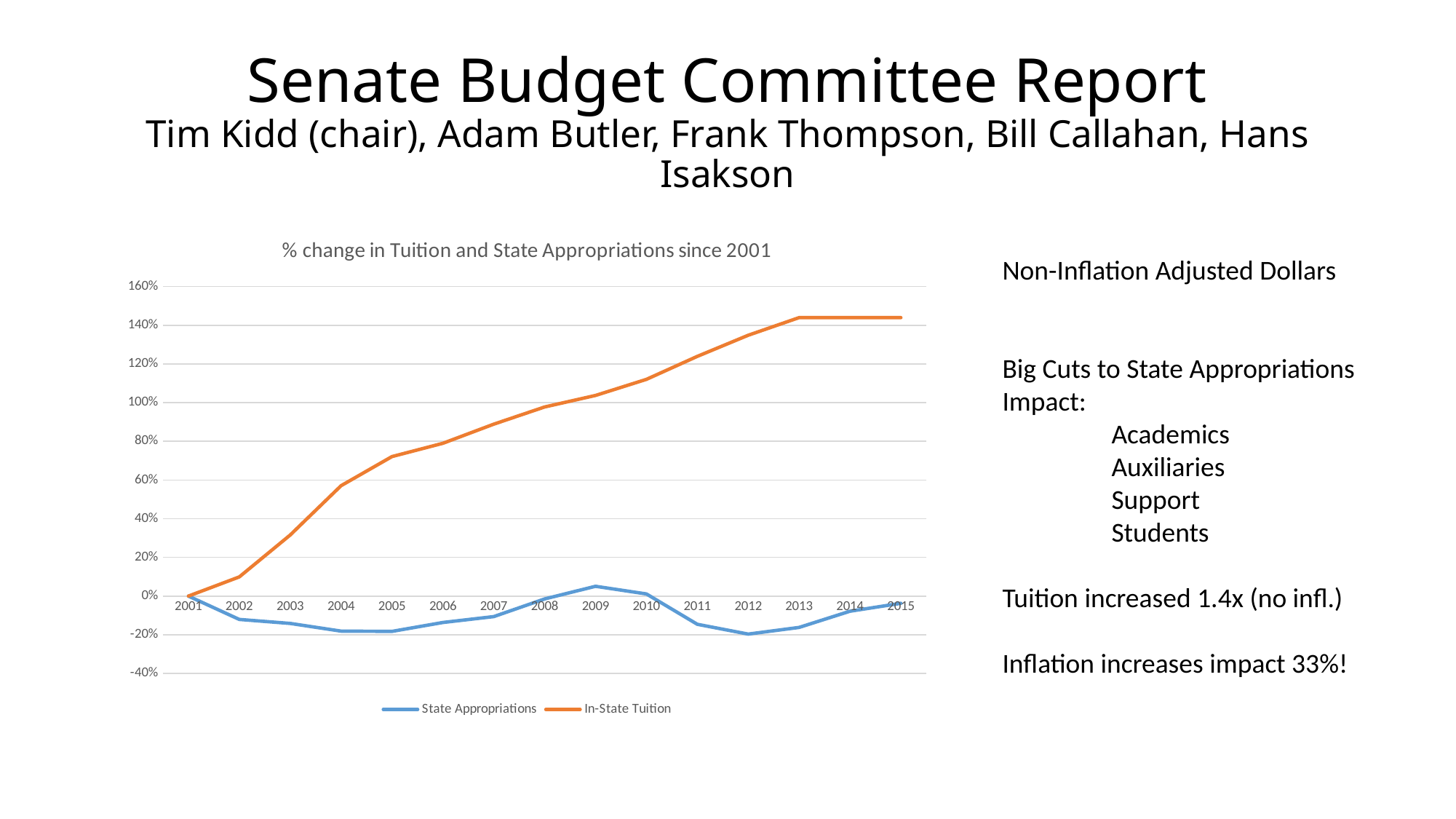
Which series is drawn in orange in the chart? In-State Tuition Is the value for In-State Tuition in 2015 greater or less than 120%? greater What is the title of the chart? % change in Tuition and State Appropriations since 2001 Is the value for State Appropriations in 2012 greater or less than 0%? less How many series does the chart's legend list? 2 In 2010, which series has the higher value, State Appropriations or In-State Tuition? In-State Tuition What kind of chart is shown on the slide? line chart How many years are plotted along the x axis of the chart? 15 Is the value for In-State Tuition in 2003 greater or less than 40%? less Does the In-State Tuition line rise or fall from 2001 to 2013? rise What is the value for In-State Tuition in 2001? 0%